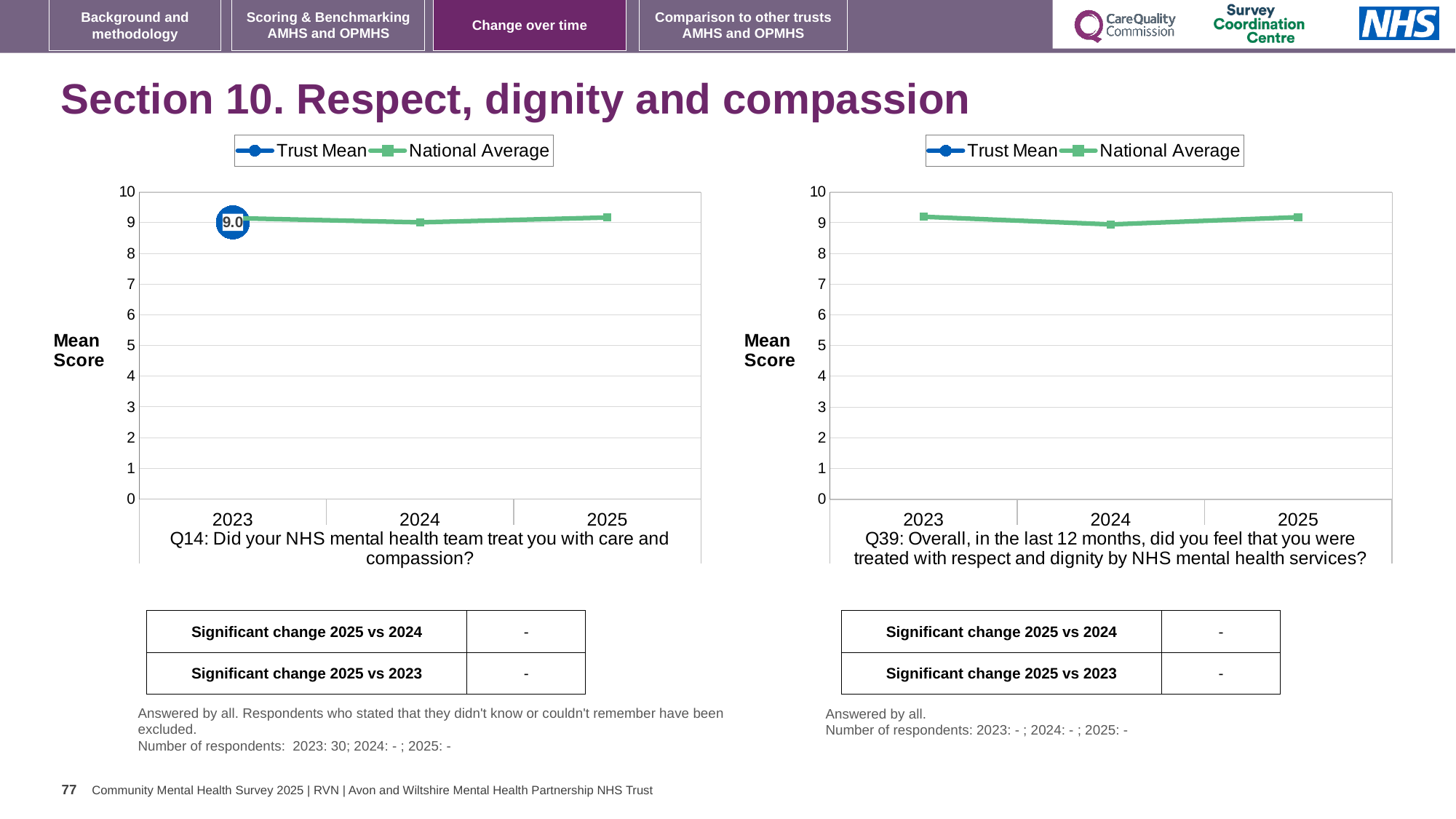
On the right chart (Q39), is the National Average value for 2025 greater or less than 5? greater What is the maximum value shown on the y axis of the right chart (Q39)? 10 How many series does the legend of the left chart (Q14) list? 2 What are the two series named in the legend of the right chart (Q39)? Trust Mean and National Average How many years are shown on the x axis of the right chart (Q39)? 3 What kind of chart is the right chart (Q39)? line chart What is the y-axis label on the left chart (Q14)? Mean Score On the left chart (Q14), what is the Trust Mean value for 2023? 9.0 On the left chart (Q14), is the Trust Mean value for 2023 greater or less than 8? greater What kind of chart is the left chart (Q14)? line chart On the right chart (Q39), which year has the lowest National Average value? 2024 On the right chart (Q39), is the National Average value for 2024 greater or less than 8? greater